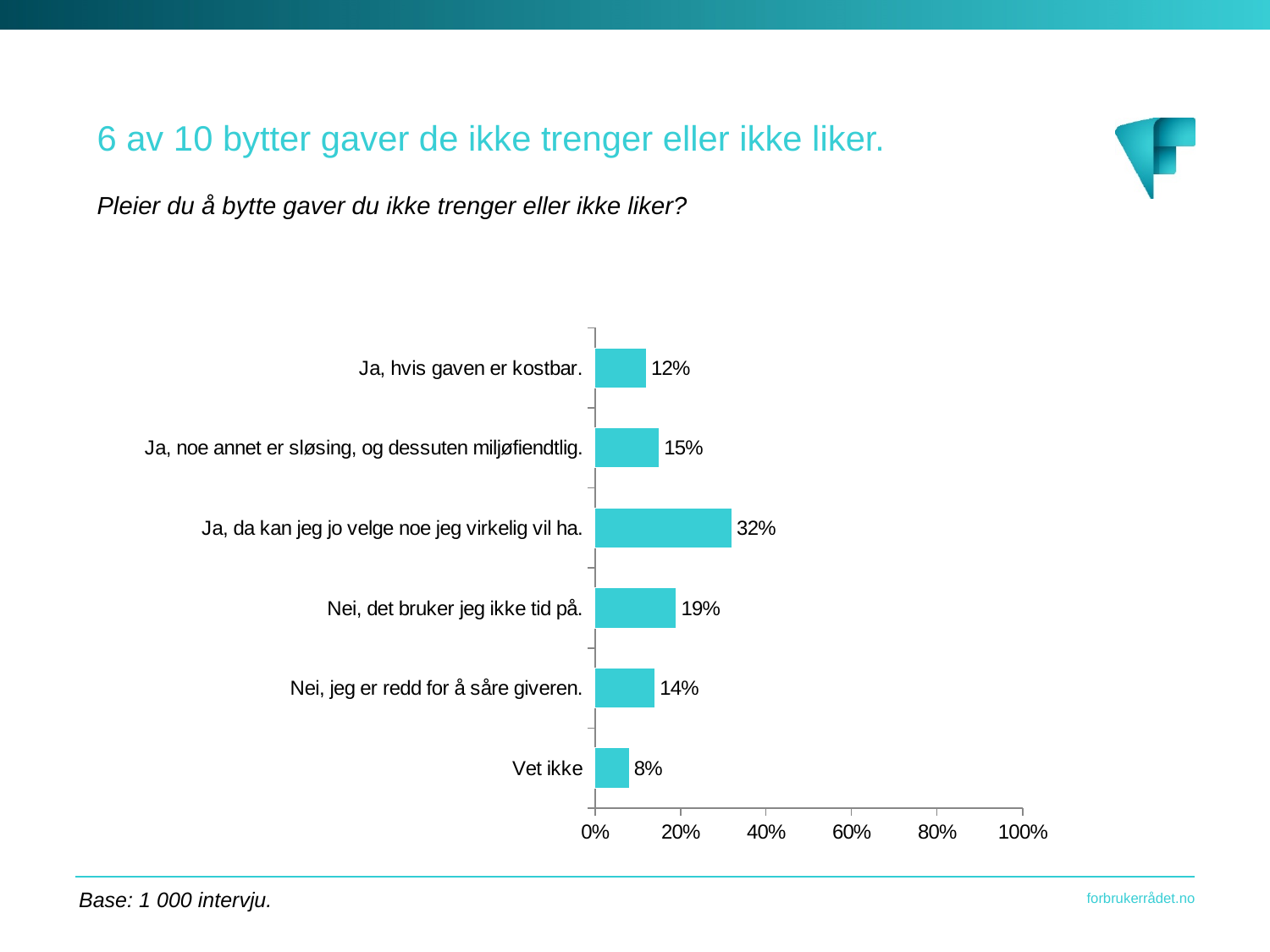
What is the combined value of the three "Ja" responses? 59% Is the value for "Nei, det bruker jeg ikke tid på." greater or less than 40%? less Which is larger: "Ja, hvis gaven er kostbar." or "Ja, noe annet er sløsing, og dessuten miljøfiendtlig."? Ja, noe annet er sløsing, og dessuten miljøfiendtlig. What is the value for "Nei, jeg er redd for å såre giveren."? 14% What is the maximum value shown on the horizontal axis? 100% What kind of chart is shown on the slide? Bar chart What is the value for "Vet ikke"? 8% Which response category has the lowest value? Vet ikke Which response category has the highest value? Ja, da kan jeg jo velge noe jeg virkelig vil ha. What is the difference between "Ja, da kan jeg jo velge noe jeg virkelig vil ha." and "Nei, det bruker jeg ikke tid på."? 13% What percentage of respondents answered "Ja, da kan jeg jo velge noe jeg virkelig vil ha."? 32% How many response categories are shown in the chart? 6